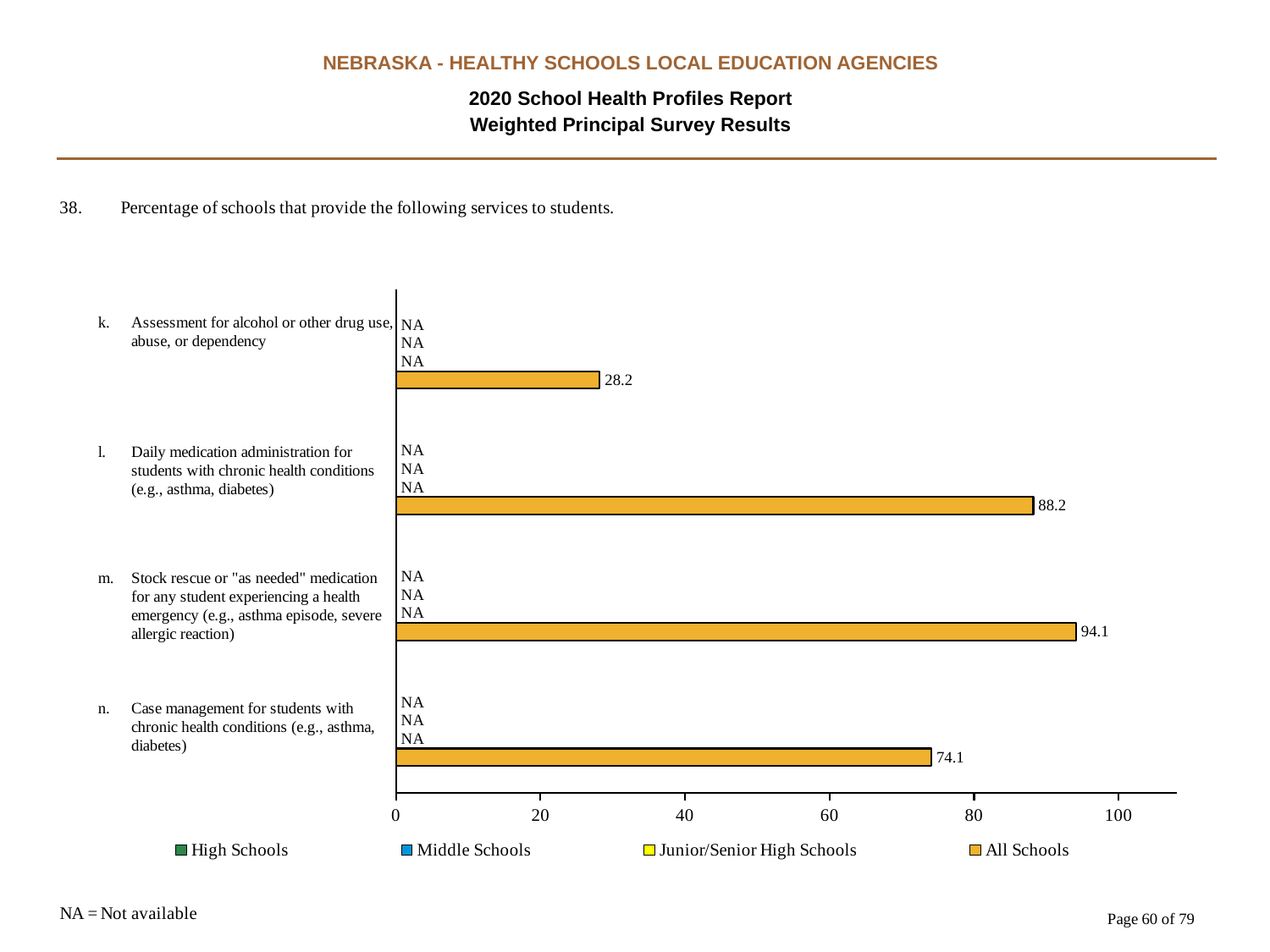
What is the All Schools value for 'Assessment for alcohol or other drug use, abuse, or dependency'? 28.2 Which service has the highest All Schools percentage? Stock rescue or "as needed" medication for any student experiencing a health emergency How many series does the legend list? 4 What is the All Schools value for 'Case management for students with chronic health conditions'? 74.1 Which service has the lowest All Schools percentage? Assessment for alcohol or other drug use, abuse, or dependency What is the All Schools value for 'Daily medication administration for students with chronic health conditions'? 88.2 Which is larger for All Schools: 'Daily medication administration' or 'Case management for students with chronic health conditions'? Daily medication administration What value is shown for High Schools for 'Daily medication administration for students with chronic health conditions'? NA How many services (categories) are shown on the chart? 4 Is the All Schools value for 'Assessment for alcohol or other drug use, abuse, or dependency' greater or less than 40? less What kind of chart is shown on the slide? bar chart What is the difference between the All Schools values for 'Stock rescue or "as needed" medication' and 'Case management for students with chronic health conditions'? 20